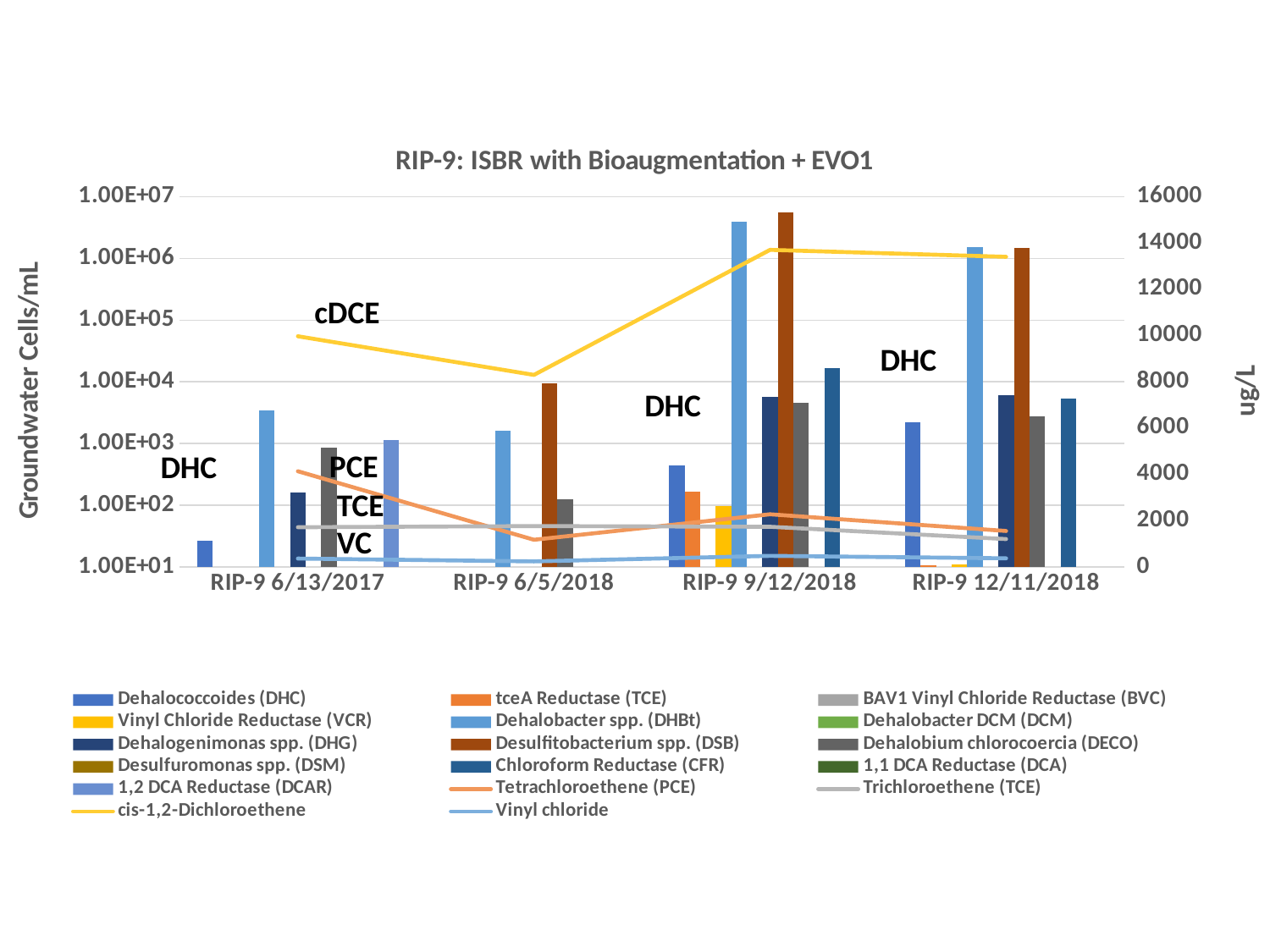
Does the cis-1,2-Dichloroethene line rise or fall between RIP-9 6/5/2018 and RIP-9 9/12/2018? rise Is the Dehalobacter spp. (DHBt) bar at RIP-9 9/12/2018 greater or less than 1.00E+06 cells/mL? greater How many sampling dates (categories) are shown on the x axis? 4 Is the Dehalococcoides (DHC) bar at RIP-9 6/13/2017 greater or less than 1.00E+02 cells/mL? less Is the cis-1,2-Dichloroethene value at RIP-9 9/12/2018 greater or less than 12000 on the right axis? greater Which date has the taller Dehalobacter spp. (DHBt) bar, RIP-9 9/12/2018 or RIP-9 12/11/2018? RIP-9 9/12/2018 What is the title of the chart? RIP-9: ISBR with Bioaugmentation + EVO1 What is the label of the left vertical axis? Groundwater Cells/mL At which sampling date is the cis-1,2-Dichloroethene line at its lowest? RIP-9 6/5/2018 What type of chart is shown on the slide? Combined bar and line chart How many series does the legend list? 17